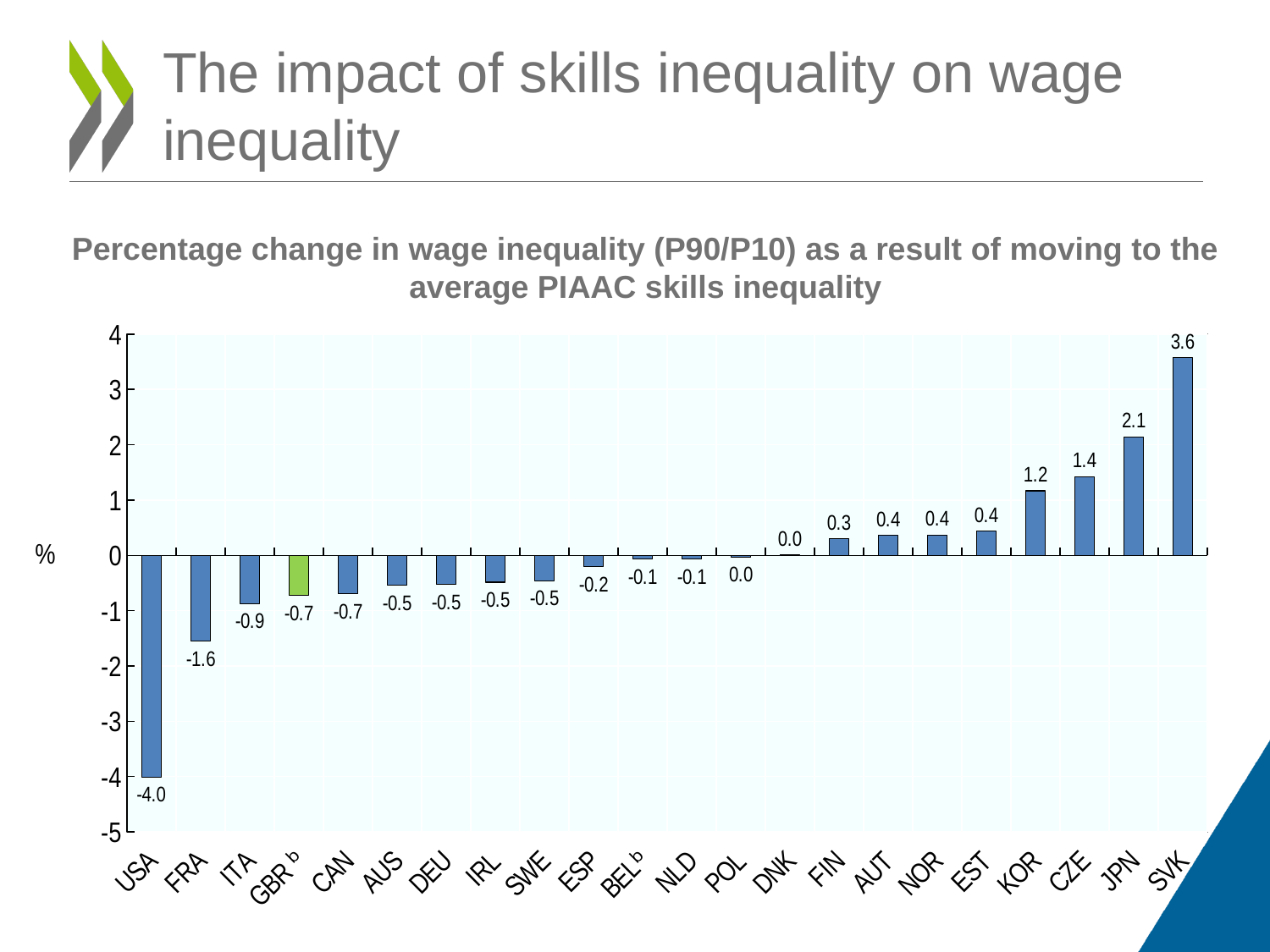
What is the difference between the values for SVK and JPN? 1.5 Which country's bar is coloured green rather than blue? GBR Which country has the highest value? SVK How many countries are shown on the x axis? 22 What is the value for SVK? 3.6 Which country has the lowest value? USA What is the value for USA? -4.0 What is the difference between the values for FRA and USA? 2.4 What type of chart is shown? Bar chart What is the value for FRA? -1.6 What is the value for JPN? 2.1 Which has a larger value, KOR or CZE? CZE